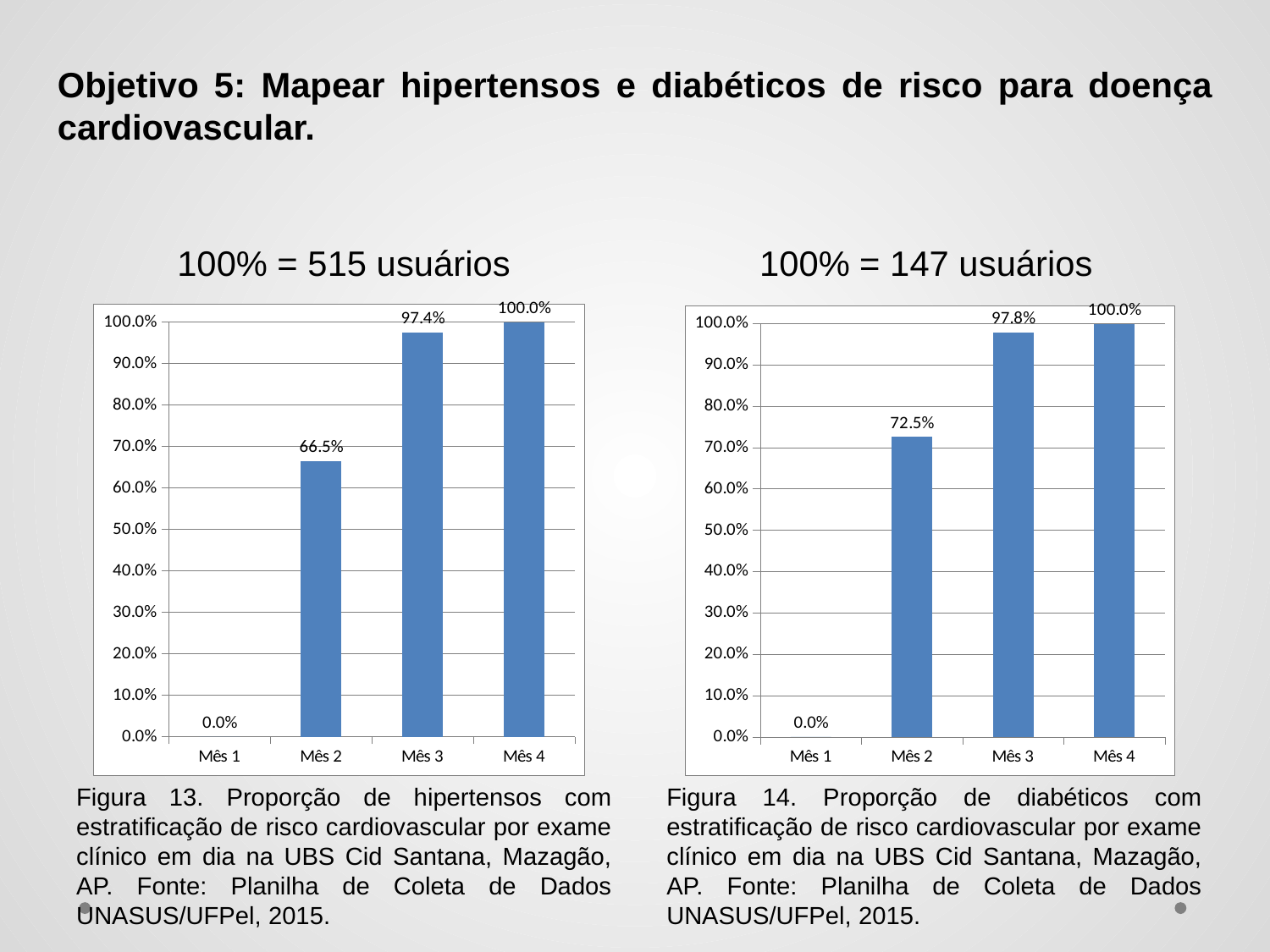
In the left chart (Figura 13, hipertensos), what is the difference between the values for Mês 3 and Mês 2? 30.9% In the right chart (Figura 14, diabéticos), do the values rise or fall from Mês 1 to Mês 4? Rise In the left chart (Figura 13, hipertensos), which month has the lowest value? Mês 1 In the left chart (Figura 13, hipertensos), what is the value for Mês 3? 97.4% In the left chart (Figura 13, hipertensos), what is the value for Mês 2? 66.5% Which is larger: the Mês 2 value in the left chart (hipertensos) or the Mês 2 value in the right chart (diabéticos)? The right chart (diabéticos), 72.5% What type of chart is used in Figura 14 (right chart)? Bar chart In the right chart (Figura 14, diabéticos), what is the value for Mês 3? 97.8% In the right chart (Figura 14, diabéticos), which month has the highest value? Mês 4 How many months (categories) are shown on the x axis of the left chart (Figura 13)? 4 In the right chart (Figura 14, diabéticos), what is the difference between the values for Mês 4 and Mês 2? 27.5% In the right chart (Figura 14, diabéticos), what is the value for Mês 2? 72.5%